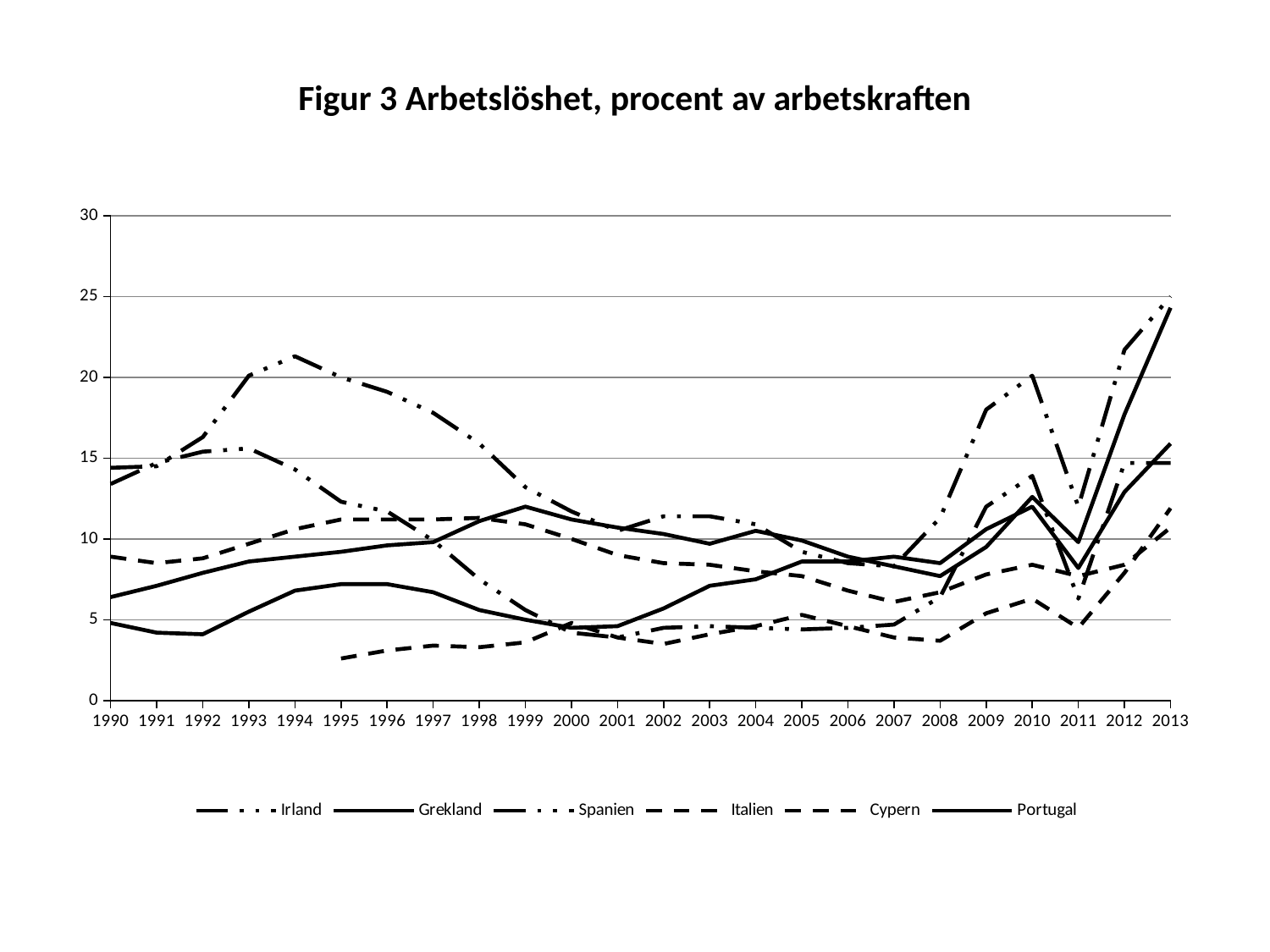
Does the value for Grekland rise or fall from 2008 to 2013? rise What kind of chart is shown on the slide? line chart Is the value for Cypern in 1995 greater or less than 5? less How many series does the legend list? 6 Is the value for Spanien in 1994 greater or less than 20? greater In 1990, which is larger, the value for Grekland or the value for Portugal? Grekland Is the value for Grekland in 1990 greater or less than 10? less What is the title of the chart? Figur 3 Arbetslöshet, procent av arbetskraften How many years are shown along the x axis? 24 Which series has the highest value in 1994? Spanien Which series only begins in 1995 rather than 1990? Cypern